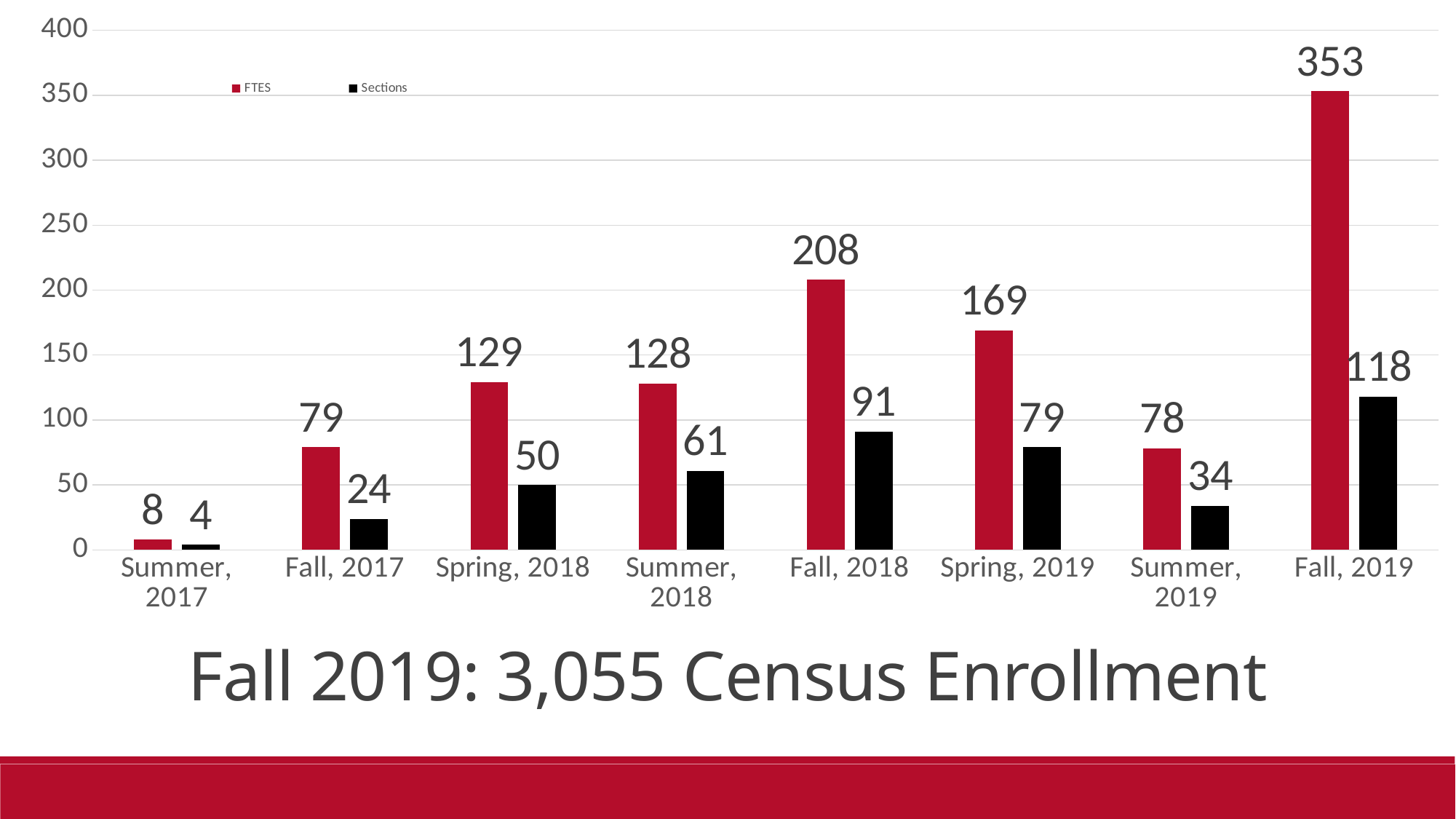
What is the Sections value for Spring, 2018? 50 Is the FTES value for Fall, 2019 greater or less than 300? greater What is the FTES value for Summer, 2019? 78 Which term has the highest FTES value? Fall, 2019 What is the difference between the FTES value for Fall, 2019 and the FTES value for Fall, 2018? 145 How many terms are shown on the x axis? 8 What kind of chart is shown on the slide? bar chart Which term has the lowest Sections value? Summer, 2017 What is the difference between the Sections values for Fall, 2019 and Fall, 2018? 27 Which is larger, the FTES value for Spring, 2019 or the FTES value for Spring, 2018? Spring, 2019 How many series does the legend list? 2 What is the FTES value for Fall, 2018? 208